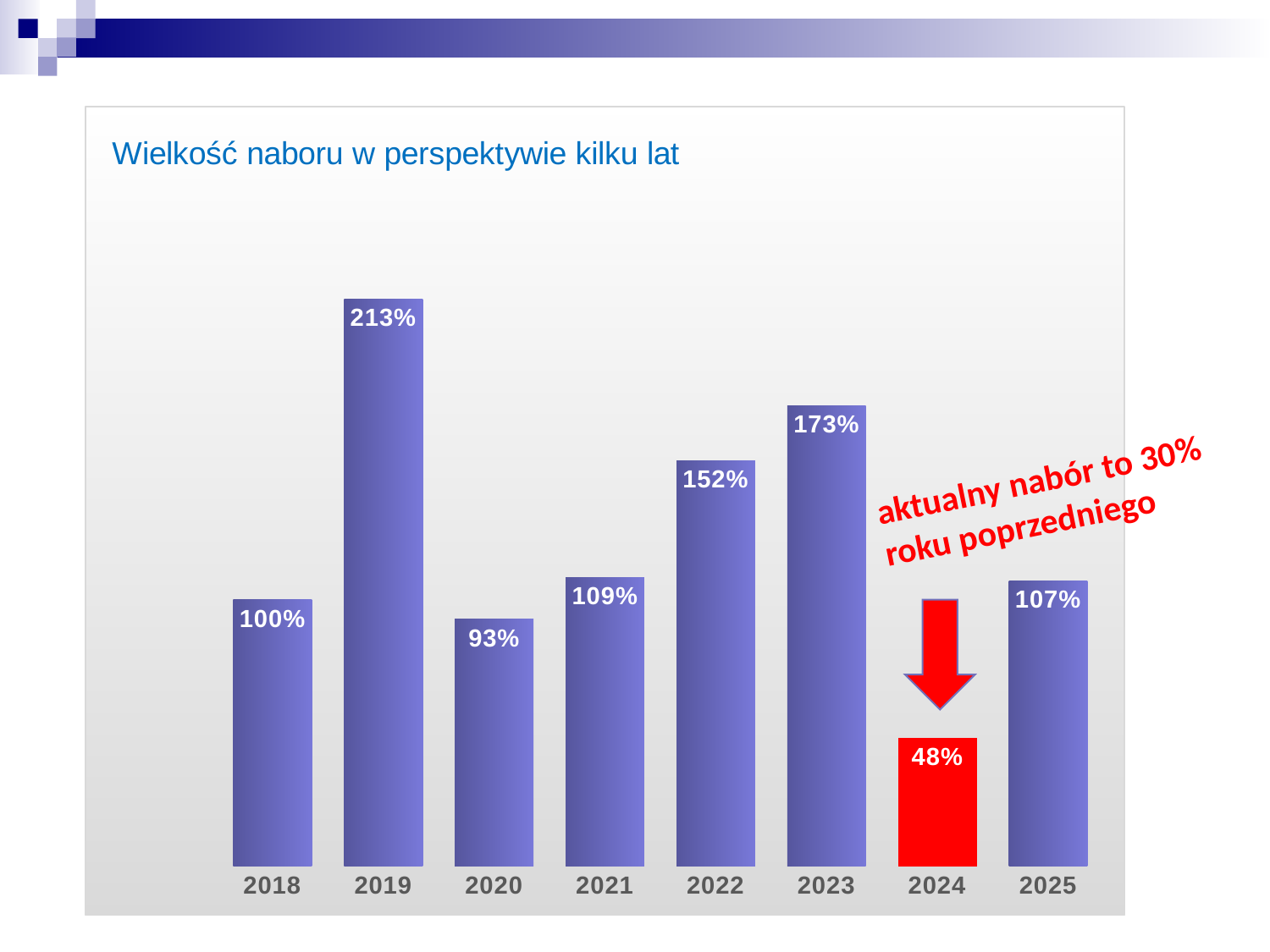
What is the value for 2024? 48% Which year has the highest value? 2019 What is the difference between the values for 2023 and 2024? 125% Which is larger, the value for 2021 or the value for 2025? 2021 How many years are shown on the x axis? 8 What is the title of the chart? Wielkość naboru w perspektywie kilku lat What is the value for 2022? 152% What kind of chart is shown? bar chart Which year's bar is coloured red? 2024 What is the value for 2019? 213% Which year has the lowest value? 2024 Do the values rise or fall from 2023 to 2024? fall